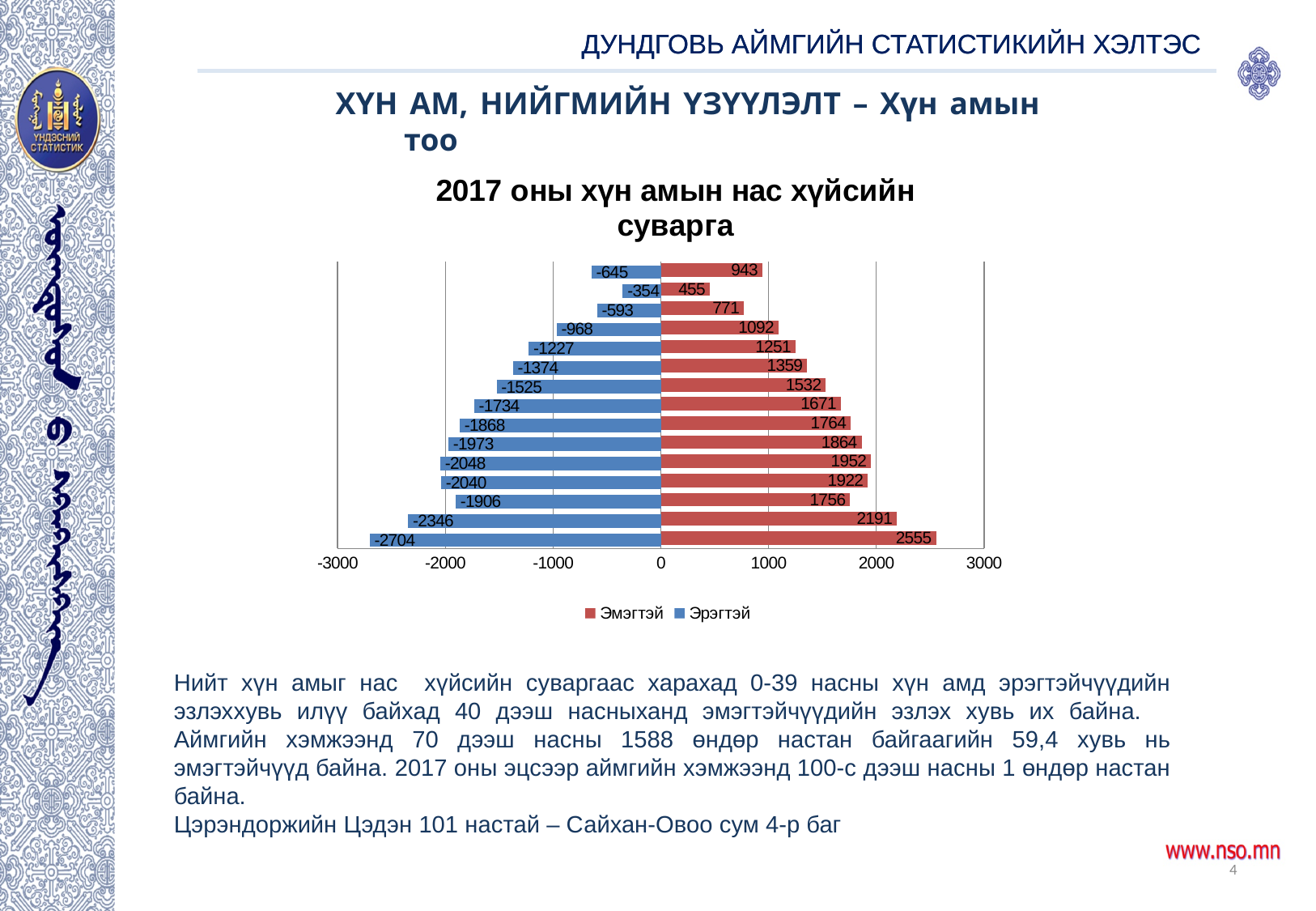
How many bars are plotted for the Эмэгтэй series? 15 For the bottom pair of bars, which series has the larger magnitude, Эмэгтэй or Эрэгтэй? Эрэгтэй What is the value labelled on the bottom bar of the Эрэгтэй series? -2704 What is the largest value labelled in the Эмэгтэй series? 2555 What is the value labelled on the top bar of the Эмэгтэй series? 943 By how much does the magnitude of the bottom Эрэгтэй bar (2704) exceed the bottom Эмэгтэй bar (2555)? 149 How many series does the legend list? 2 What is the value labelled on the top bar of the Эрэгтэй series? -645 What is the smallest value labelled in the Эмэгтэй series? 455 What type of chart is shown on the slide? bar chart What is the title of the chart? 2017 оны хүн амын нас хүйсийн суварга Which two series are listed in the legend? Эмэгтэй and Эрэгтэй